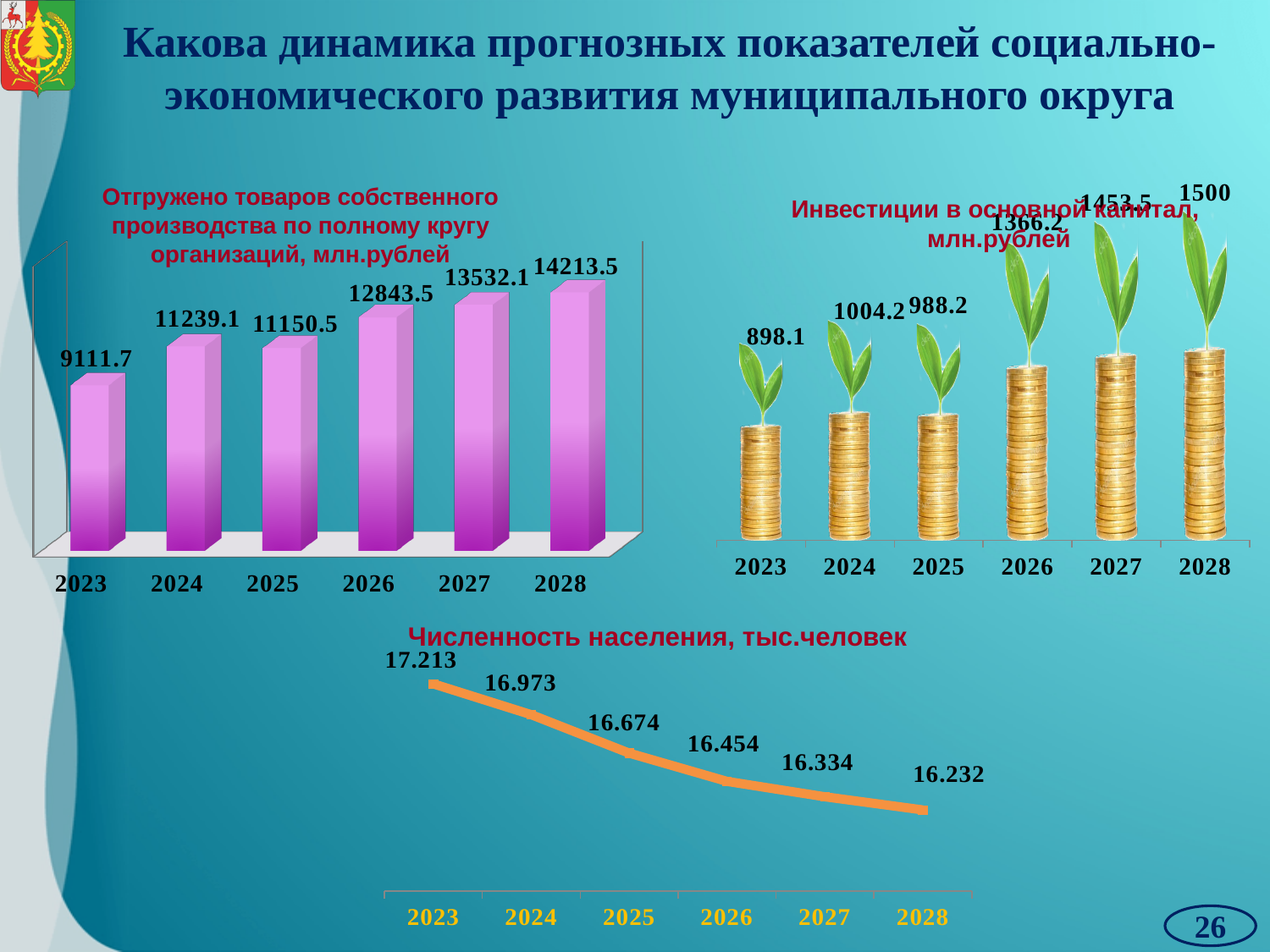
In the chart 'Инвестиции в основной капитал, млн.рублей', which year has the lowest value? 2023 In the chart 'Отгружено товаров собственного производства по полному кругу организаций, млн.рублей', what is the value for 2023? 9111.7 In the chart 'Отгружено товаров собственного производства по полному кругу организаций, млн.рублей', which is larger, the value for 2024 or 2025? 2024 What kind of chart is 'Отгружено товаров собственного производства по полному кругу организаций, млн.рублей'? bar chart In the chart 'Численность населения, тыс.человек', what is the value for 2025? 16.674 In the chart 'Численность населения, тыс.человек', what is the difference between the values for 2023 and 2028? 0.981 In the chart 'Инвестиции в основной капитал, млн.рублей', what is the value for 2026? 1366.2 How many years are shown in the chart 'Инвестиции в основной капитал, млн.рублей'? 6 In the chart 'Отгружено товаров собственного производства по полному кругу организаций, млн.рублей', which year has the highest value? 2028 In the chart 'Инвестиции в основной капитал, млн.рублей', what is the difference between the values for 2028 and 2023? 601.9 In the chart 'Численность населения, тыс.человек', do the values rise or fall from 2023 to 2028? fall In the chart 'Отгружено товаров собственного производства по полному кругу организаций, млн.рублей', what is the difference between the values for 2028 and 2027? 681.4